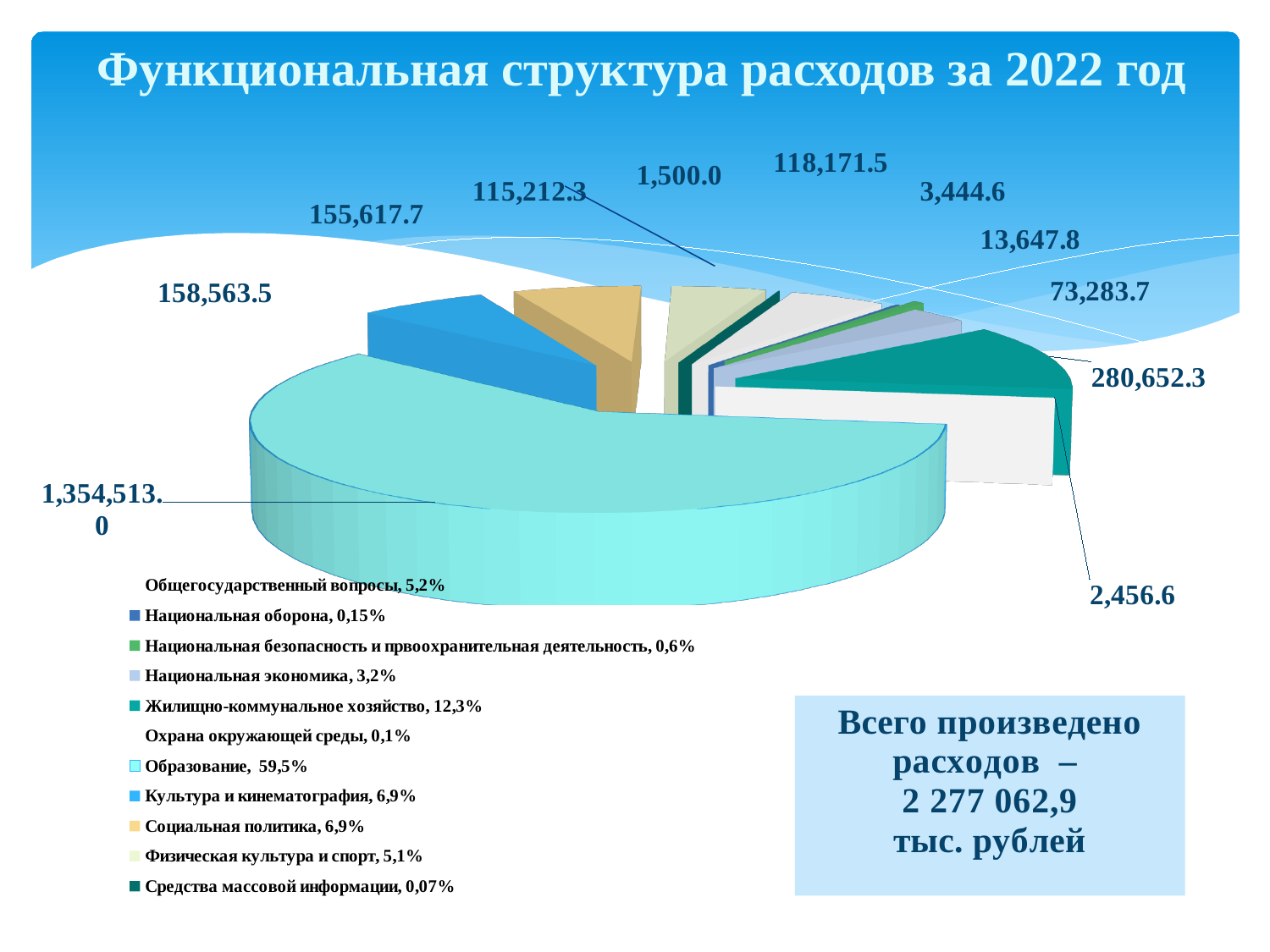
What share of the pie does Национальная оборона account for? 0,15% What is the difference in share between Жилищно-коммунальное хозяйство (12,3%) and Общегосударственные вопросы (5,2%)? 7,1% Which has the larger share: Жилищно-коммунальное хозяйство or Культура и кинематография? Жилищно-коммунальное хозяйство How many categories does the legend of the pie chart list? 11 According to the text box on the slide, what is the total amount of expenditures? 2 277 062,9 тыс. рублей What share of the pie does Образование account for? 59,5% What is the data label value shown for the Образование slice? 1,354,513.0 What kind of chart is shown on the slide? pie chart What is the title of the chart on the slide? Функциональная структура расходов за 2022 год Which category has the largest share of the pie? Образование What share of the pie does Жилищно-коммунальное хозяйство account for? 12,3%